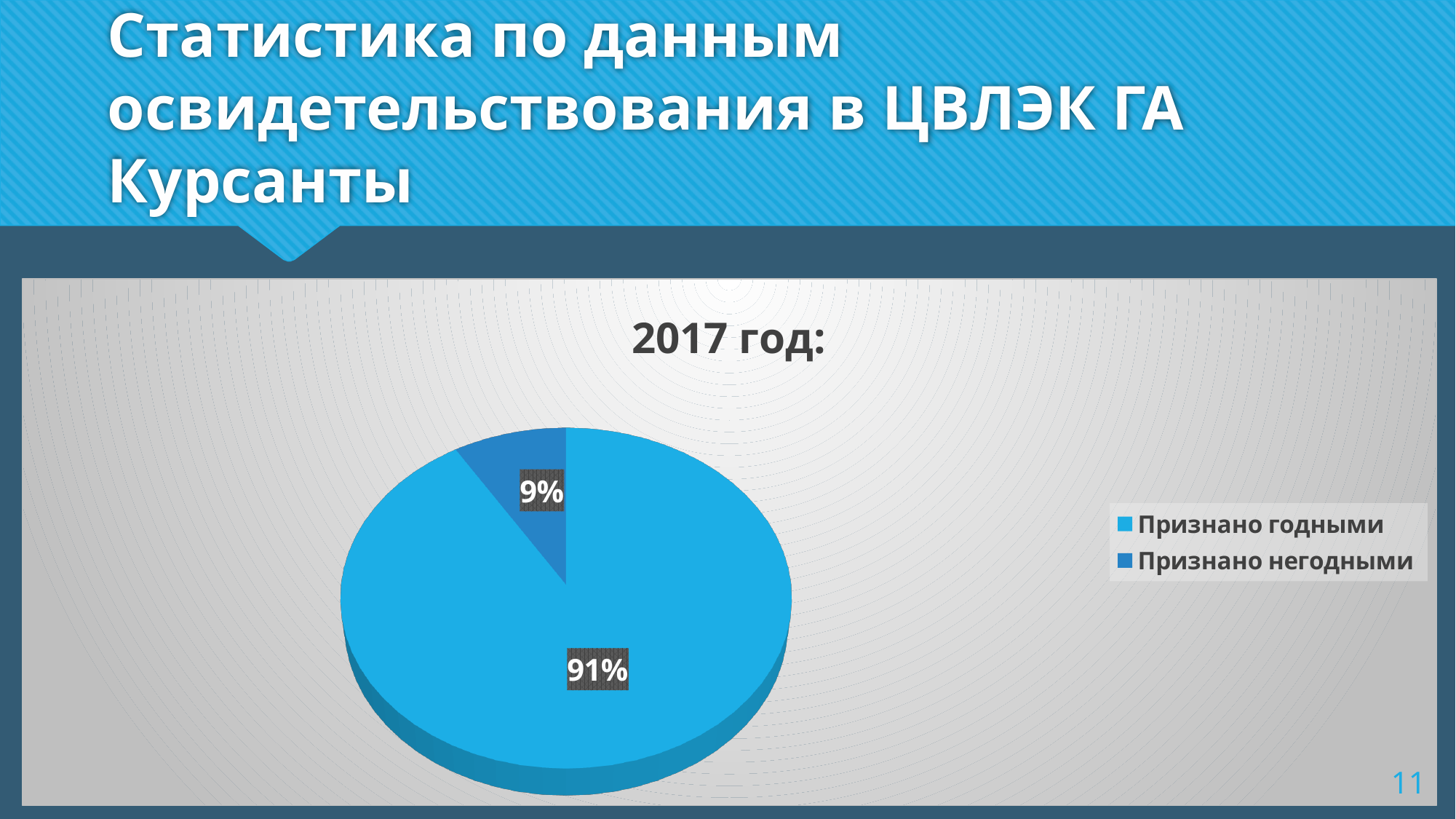
How many slices does the pie chart have? 2 Which is larger, the share for "Признано годными" or for "Признано негодными"? Признано годными Which category has the largest slice of the pie? Признано годными What is the chart's title? 2017 год: What share of the pie is labelled "Признано негодными"? 9% What is the difference in percentage points between "Признано годными" and "Признано негодными"? 82 Which category has the smallest slice of the pie? Признано негодными What share of the pie is labelled "Признано годными"? 91% How many entries does the legend list? 2 Which legend entry is shown in the darker blue colour? Признано негодными What kind of chart is shown on the slide? pie chart